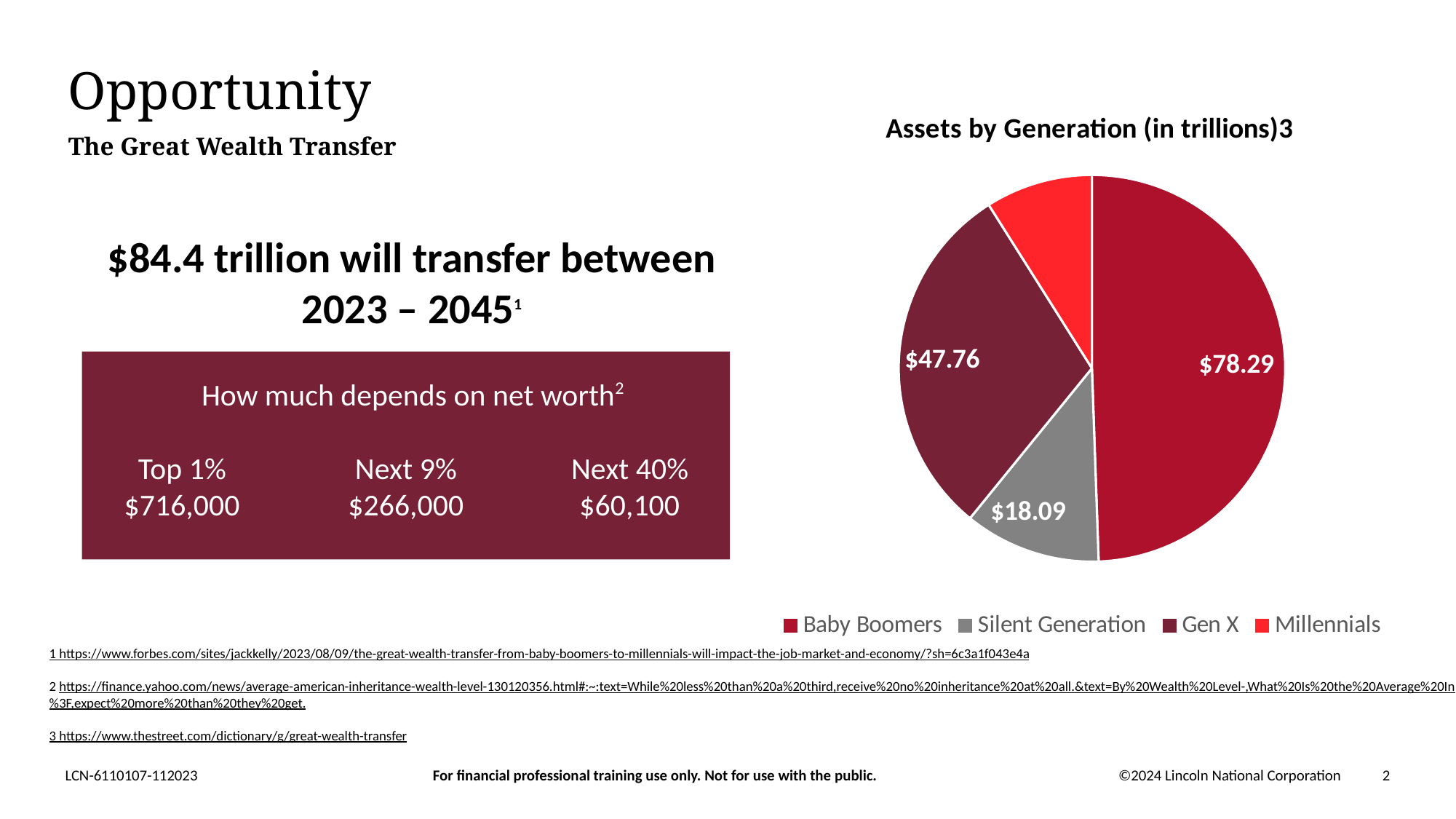
What is the value shown for the Silent Generation? $18.09 What type of chart is shown on the slide? Pie chart Which generation has the largest share of assets in the pie chart? Baby Boomers What is the difference between the Baby Boomers value and the Gen X value? $30.53 What is the difference between the Gen X value and the Silent Generation value? $29.67 Which is larger, the value for Gen X or the value for the Silent Generation? Gen X How many entries does the chart legend list? 4 How many generations are shown in the pie chart? 4 What is the value shown for Baby Boomers? $78.29 Which is larger, the value for Baby Boomers or the value for Gen X? Baby Boomers What is the value shown for Gen X? $47.76 What is the title of the chart? Assets by Generation (in trillions)3